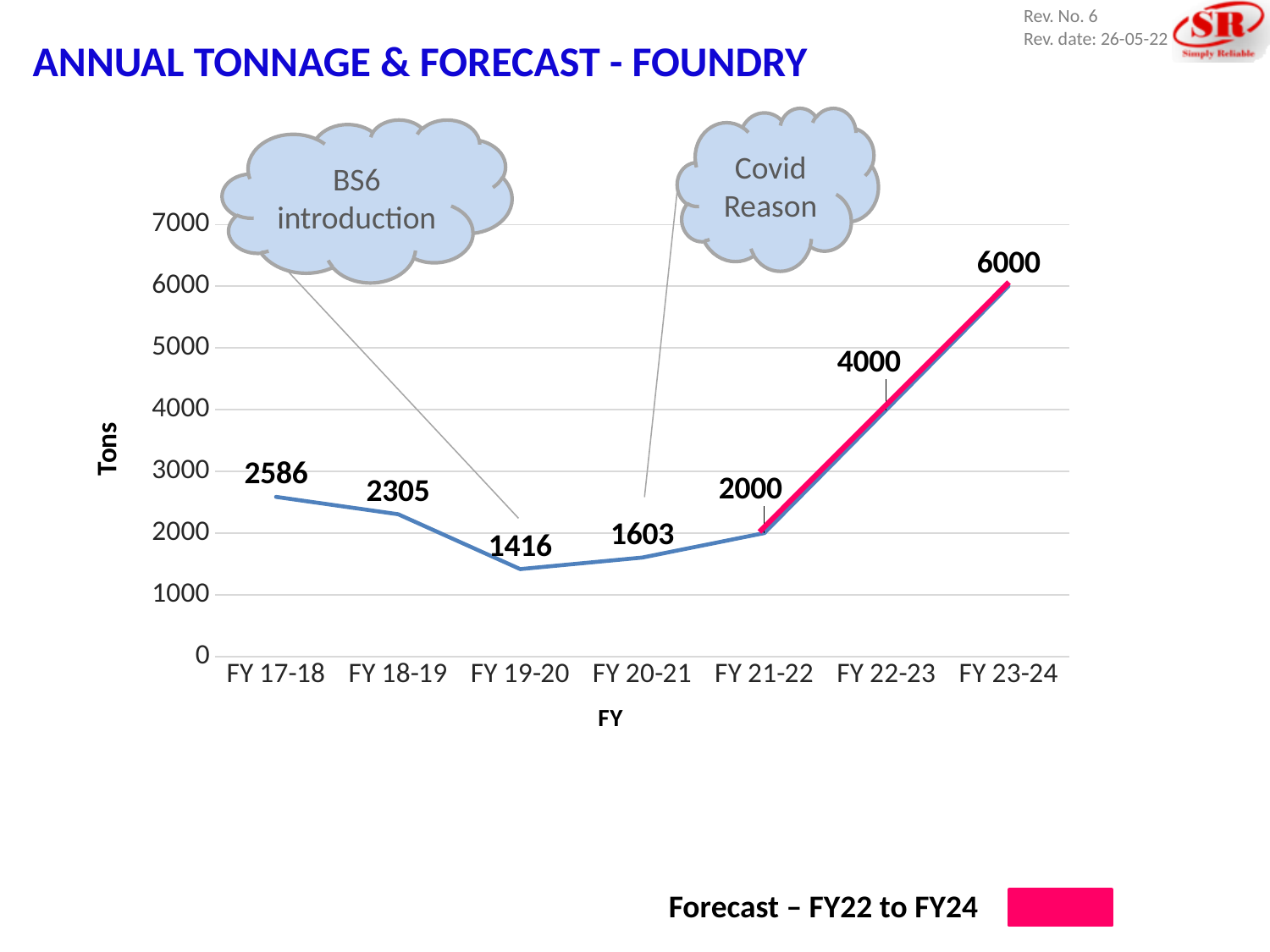
What kind of chart is shown on the slide? Line chart What is the tonnage for FY 19-20? 1416 Which fiscal year has the highest tonnage? FY 23-24 How many fiscal years are plotted on the chart? 7 What is the tonnage for FY 17-18? 2586 Which is larger, the tonnage for FY 20-21 or FY 19-20? FY 20-21 What is the label of the y axis? Tons Do the values rise or fall from FY 21-22 to FY 23-24? Rise What is the difference in tonnage between FY 17-18 and FY 18-19? 281 What is the forecast tonnage for FY 23-24? 6000 What is the difference in tonnage between FY 23-24 and FY 22-23? 2000 Which fiscal year has the lowest tonnage? FY 19-20